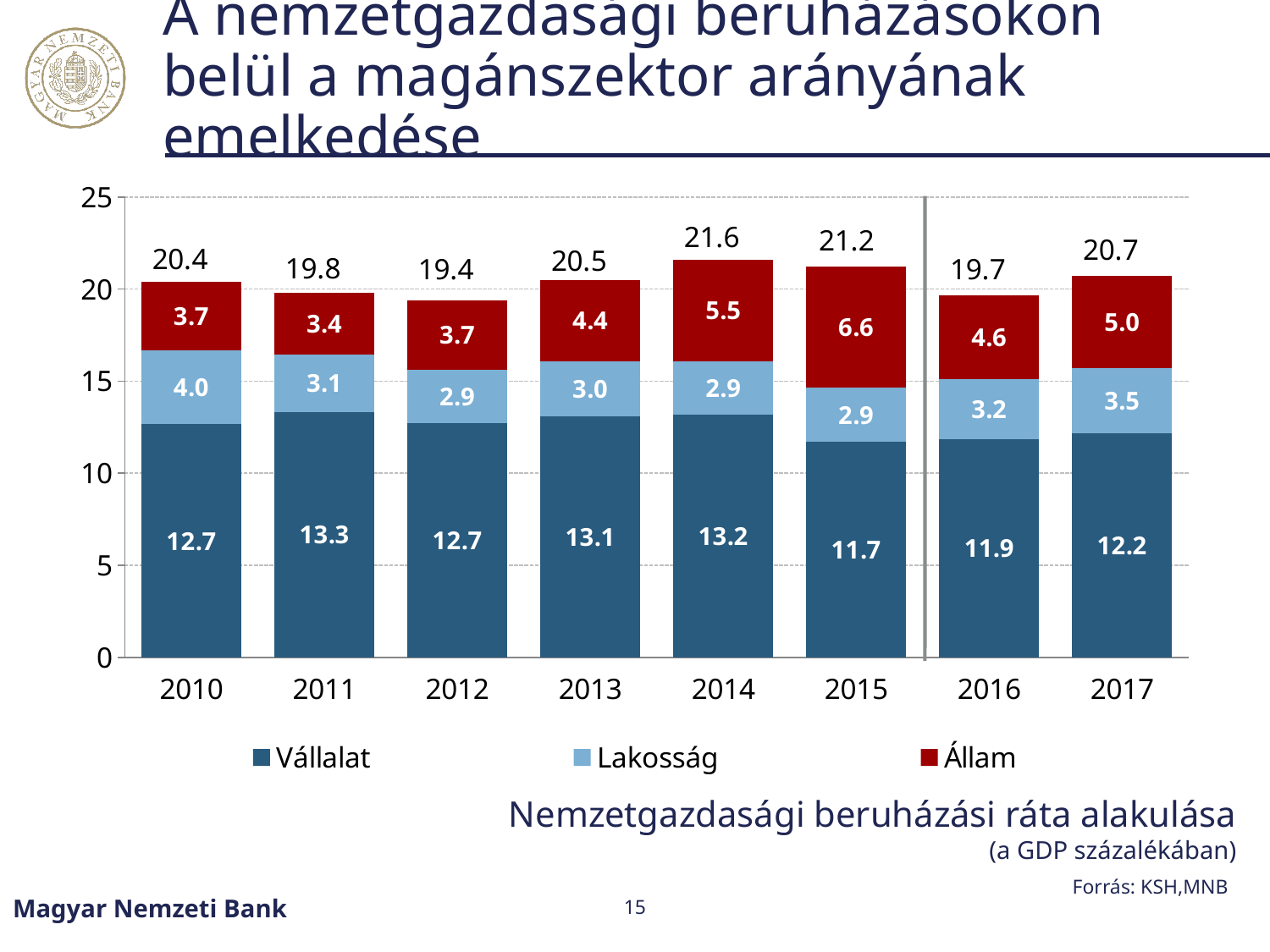
What is the total of the stacked bar for 2014? 21.6 Which series is shown in dark red in the legend? Állam Which is larger, the Vállalat value in 2015 or in 2016? 2016 Which year has the lowest total investment rate? 2012 What is the value for Vállalat in 2011? 13.3 How many years are shown on the x axis? 8 What kind of chart is shown on the slide? Stacked bar chart How many series does the legend list? 3 What is the value for Lakosság in 2010? 4.0 What is the value for Állam in 2015? 6.6 Which year has the highest total investment rate? 2014 What is the difference between the Állam values for 2015 and 2010? 2.9